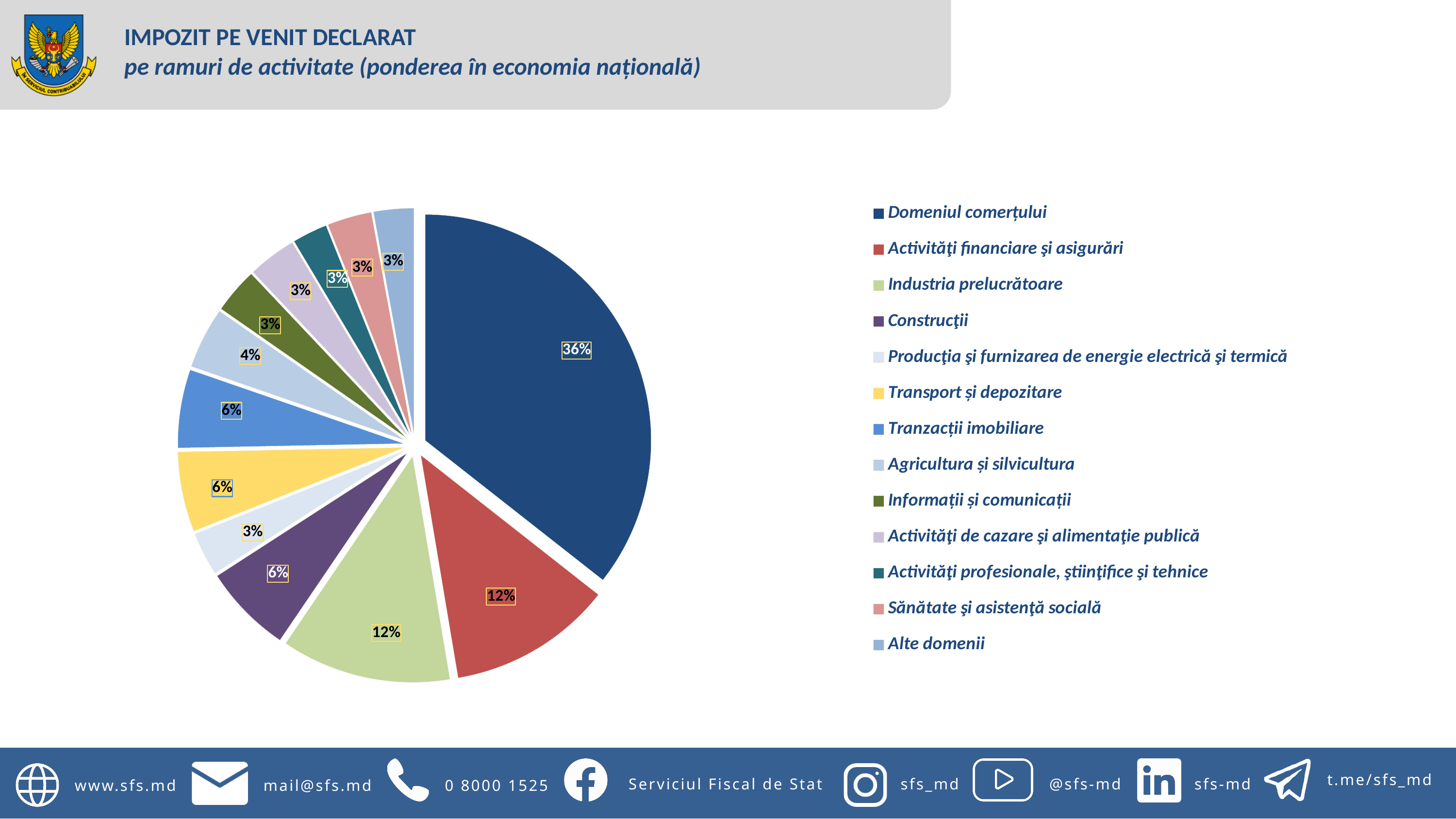
What is the value shown for Agricultura și silvicultura? 4% Which is larger, the share of Construcții or the share of Agricultura și silvicultura? Construcții What is the difference between the share of Domeniul comerțului and the share of Activități financiare și asigurări? 24% What is the value shown for Transport și depozitare? 6% How many categories does the legend list? 13 What is the value shown for Industria prelucrătoare? 12% What share of the pie does Domeniul comerțului hold? 36% What is the value shown for Sănătate și asistență socială? 3% What is the value shown for Activități financiare și asigurări? 12% What kind of chart is shown on the slide? pie chart Which category has the largest share of the pie? Domeniul comerțului What colour is the slice for Transport și depozitare? yellow